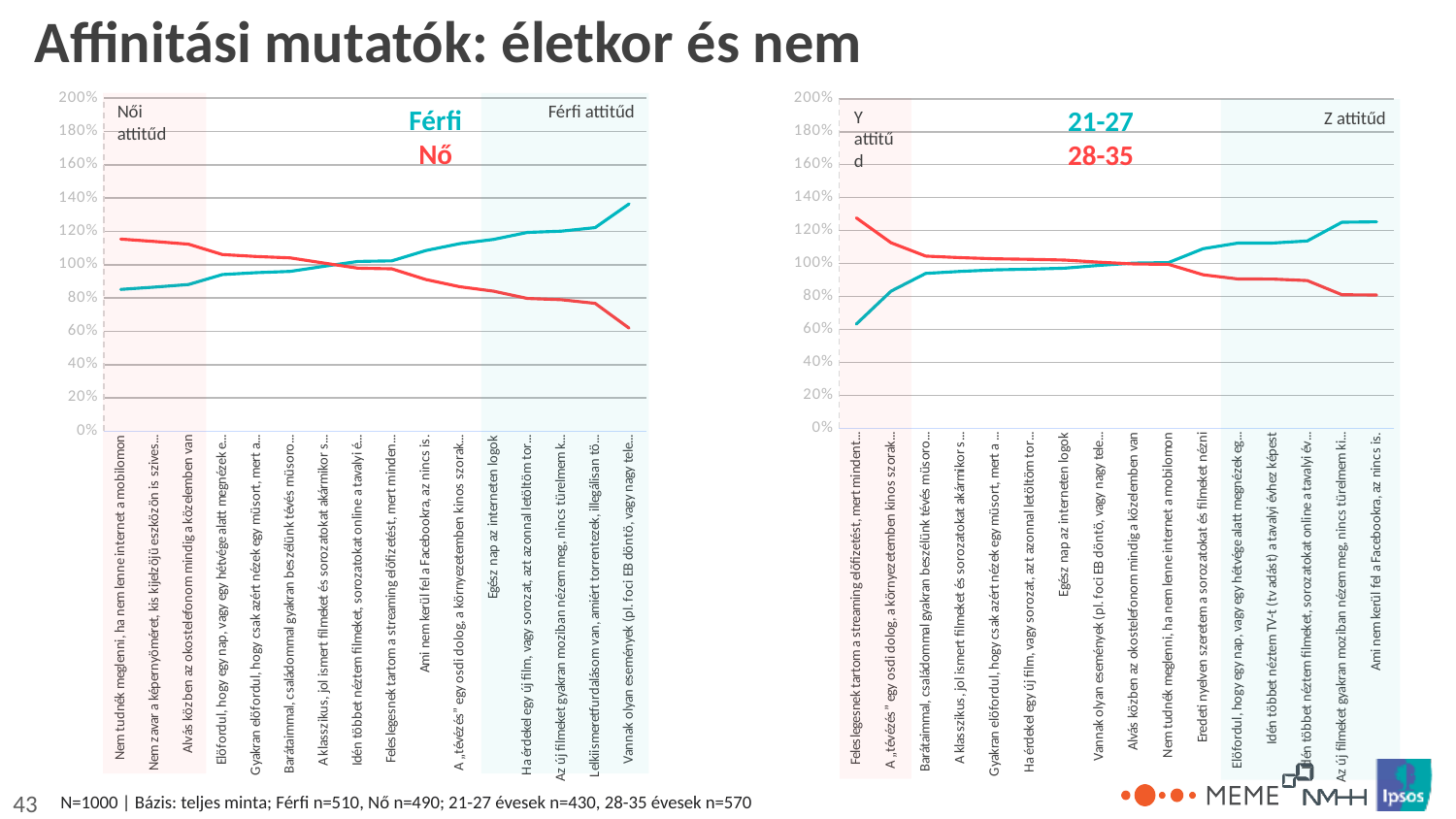
In the right chart, is the 21-27 value for 'Feleslegesnek tartom a streaming előfizetést, mert mindent...' greater or less than 80%? less In the left chart, which series has the higher value for 'Vannak olyan események (pl. foci EB döntő, vagy nagy tele...', Férfi or Nő? Férfi In the left chart, is the Nő value for 'Vannak olyan események (pl. foci EB döntő, vagy nagy tele...' greater or less than 80%? less In the right chart, is the 28-35 value for 'Feleslegesnek tartom a streaming előfizetést, mert mindent...' greater or less than 120%? greater In the left chart, does the Férfi line rise or fall from left to right along the x axis? rise How many categories are plotted along the x axis of the left chart? 16 In the right chart, does the 28-35 line rise or fall from left to right along the x axis? fall What kind of chart is the left chart (Férfi / Nő)? line chart How many series does the legend of the right chart list? 2 What are the two series names shown in the legend of the right chart? 21-27 and 28-35